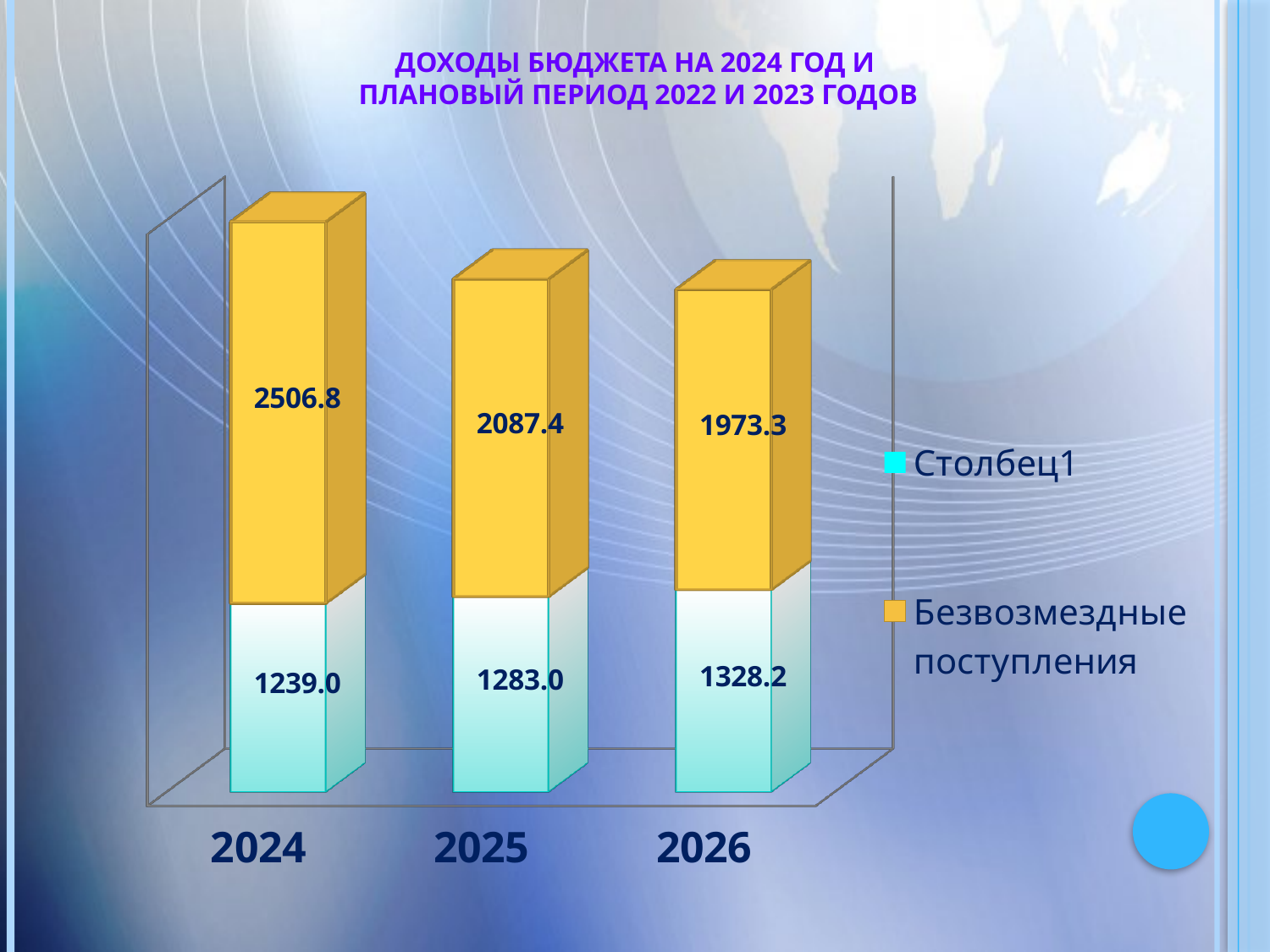
What is the difference between the Безвозмездные поступления values for 2024 and 2026? 533.5 Which year has the lowest value for Столбец1? 2024 What kind of chart is shown on the slide? Stacked bar chart Is the Столбец1 value larger for 2025 or for 2026? 2026 Which year has the highest value for Безвозмездные поступления? 2024 How many series does the legend list? 2 What is the value of Столбец1 for 2026? 1328.2 How many years are shown on the x axis? 3 What is the value of Безвозмездные поступления for 2025? 2087.4 What is the value of Безвозмездные поступления for 2024? 2506.8 Do the Безвозмездные поступления values rise or fall from 2024 to 2026? Fall What is the total of the stacked bar for 2025? 3370.4